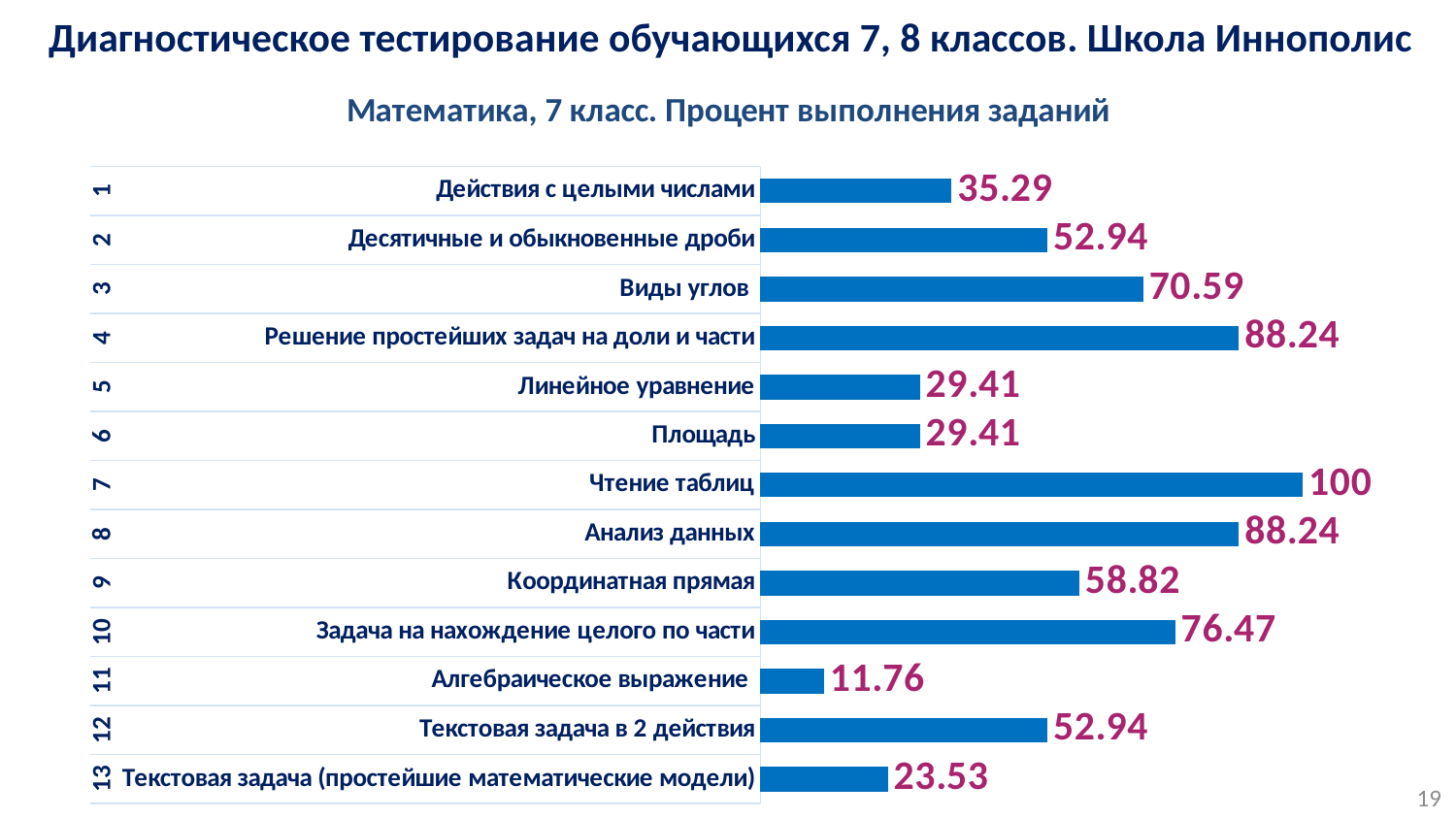
Which is larger: the value for Задача на нахождение целого по части or the value for Десятичные и обыкновенные дроби? Задача на нахождение целого по части What kind of chart is shown on the slide? Bar chart Which category has the lowest value? Алгебраическое выражение What is the difference between the values for Анализ данных and Площадь? 58.83 What is the subtitle of the chart? Математика, 7 класс. Процент выполнения заданий What is the difference between the values for Виды углов and Действия с целыми числами? 35.30 What is the value for Текстовая задача (простейшие математические модели)? 23.53 How many categories are shown in the chart? 13 What is the value for Чтение таблиц? 100 What is the value for Координатная прямая? 58.82 Which category has the highest value? Чтение таблиц What is the value for Алгебраическое выражение? 11.76